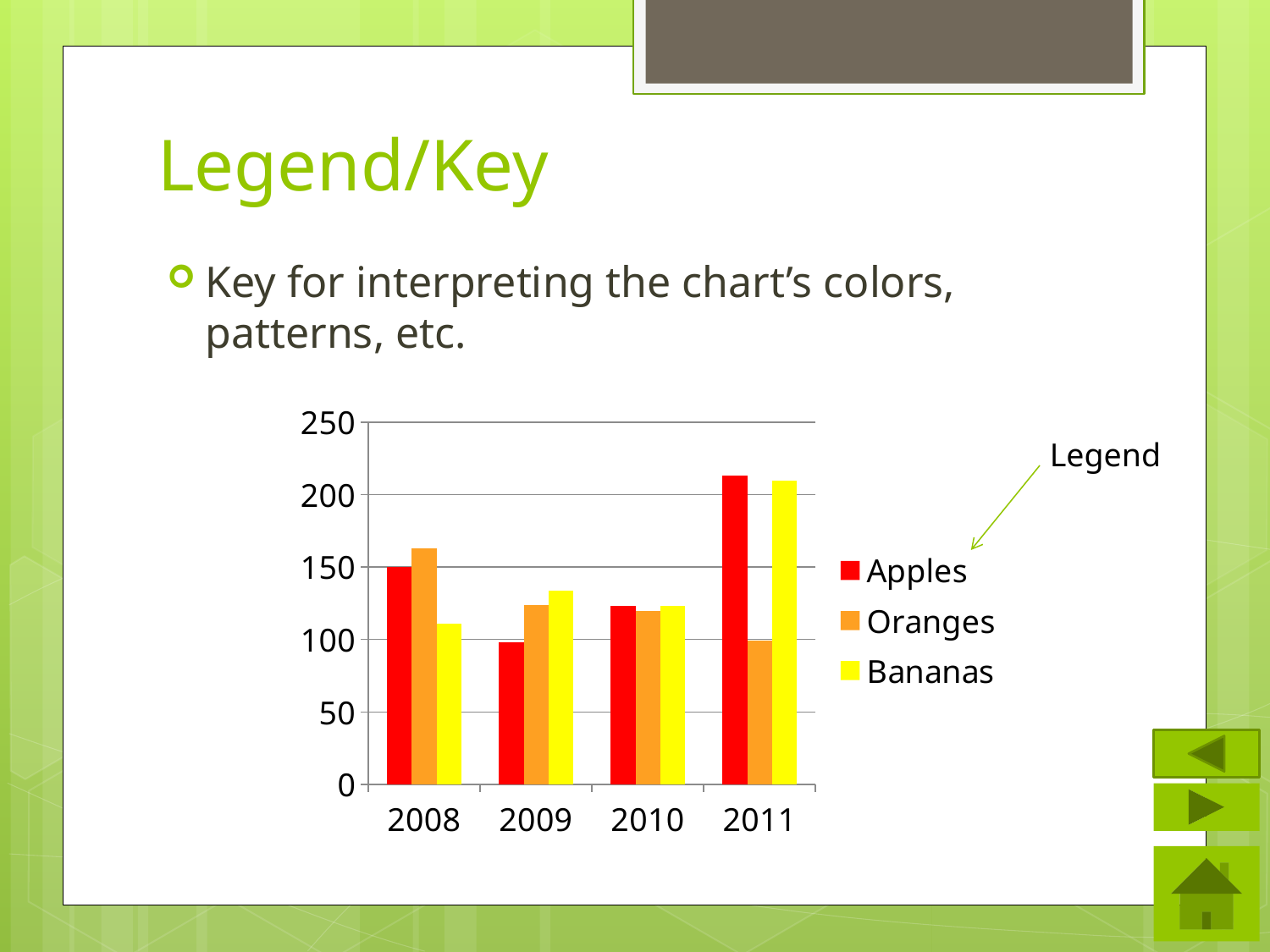
How many series does the chart's legend list? 3 How many years are shown on the x axis of the chart? 4 Is the value for Bananas in 2011 greater or less than 200? greater In 2011, which is larger: Apples or Oranges? Apples In 2008, which is larger: Oranges or Bananas? Oranges Is the value for Bananas in 2008 greater or less than 150? less What colour represents Apples in the chart's legend? red Is the value for Apples in 2011 greater or less than 200? greater What kind of chart is shown on the slide? bar chart In which year is the Apples bar the highest? 2011 In which year is the Apples bar the lowest? 2009